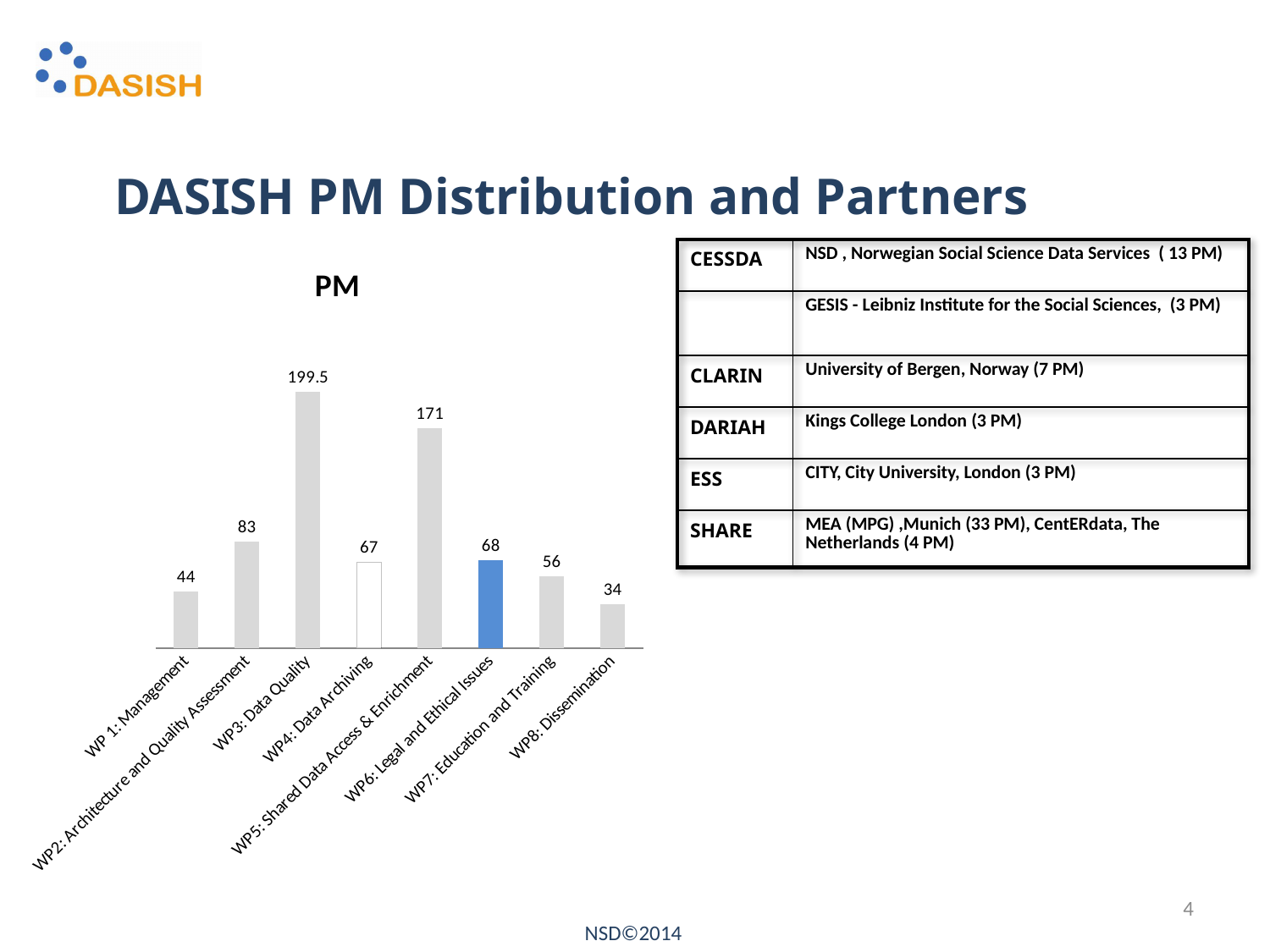
Which work package has the highest PM value? WP3: Data Quality Which work package has the lowest PM value? WP8: Dissemination Which has a larger PM value, WP2: Architecture and Quality Assessment or WP7: Education and Training? WP2: Architecture and Quality Assessment What is the PM value for WP8: Dissemination? 34 What is the title of the chart? PM What is the difference in PM between WP1: Management and WP8: Dissemination? 10 What is the difference in PM between WP3: Data Quality and WP5: Shared Data Access & Enrichment? 28.5 What is the PM value for WP3: Data Quality? 199.5 What is the PM value for WP5: Shared Data Access & Enrichment? 171 Which work package's bar is coloured blue in the PM chart? WP6: Legal and Ethical Issues How many work packages are shown in the PM chart? 8 What type of chart is used to show the PM distribution? Bar chart